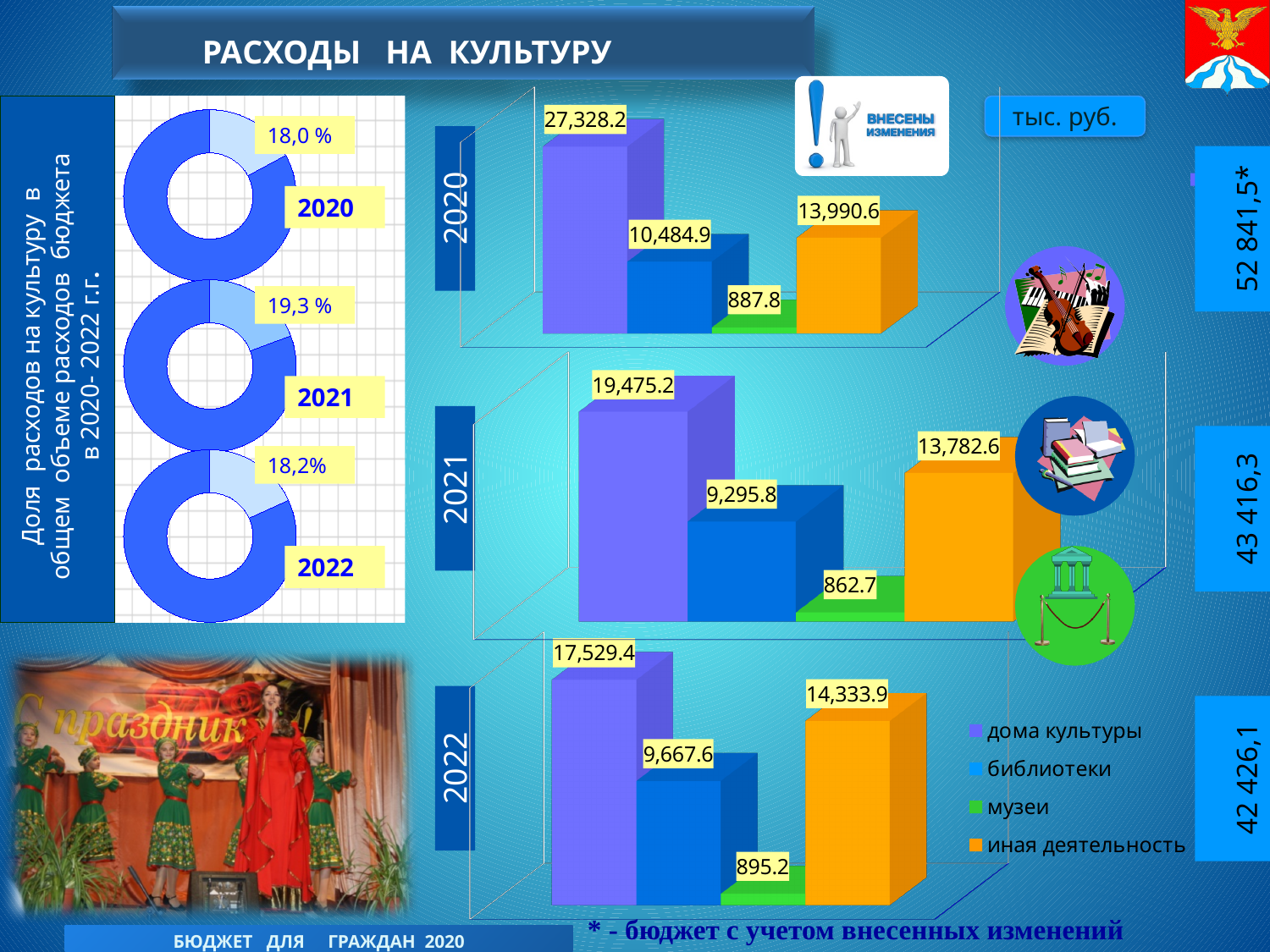
In the donut chart for 2021 on the left, what share of total budget expenditure goes to culture? 19,3 % In the 2020 bar chart, which category has the highest value? дома культуры What kind of chart is used to show the 2020, 2021 and 2022 expenditure breakdowns on the right side of the slide? bar chart In the 2022 bar chart, what is the difference between дома культуры and библиотеки? 7,861.8 In the 2022 bar chart, what is the value for иная деятельность? 14,333.9 In the 2020 bar chart, what is the value for дома культуры? 27,328.2 In the 2021 bar chart, which is larger: библиотеки or иная деятельность? иная деятельность In the 2022 bar chart, what is the value for музеи? 895.2 How many series does the legend of the bar charts list? 4 In the 2021 bar chart, which category has the lowest value? музеи In the 2021 bar chart, what is the value for библиотеки? 9,295.8 What unit is shown for the values in the bar charts? тыс. руб.